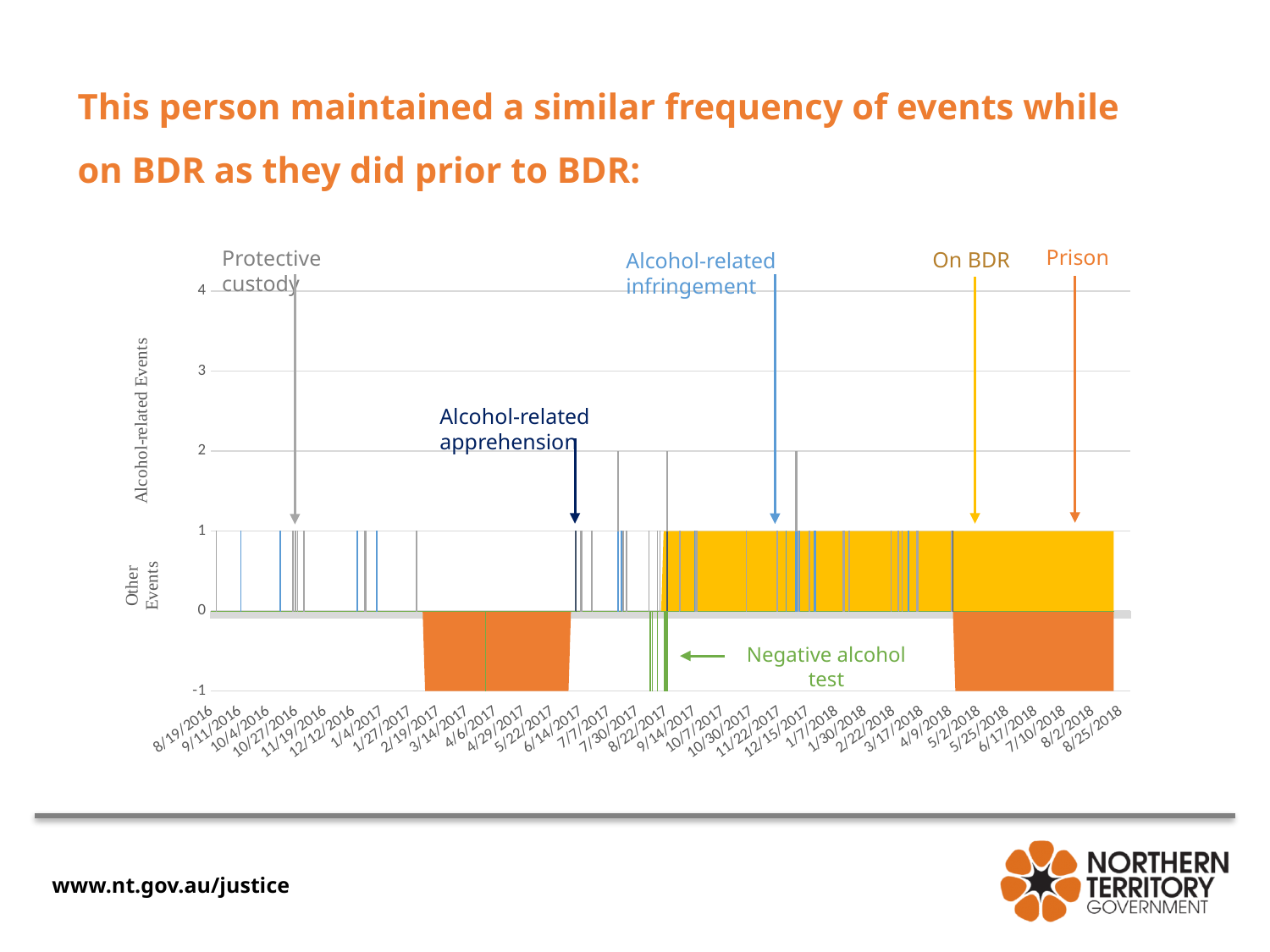
Is the value plotted for the On BDR period greater or less than 0? greater What kind of chart is shown on the slide? bar chart How many different event types are labelled with arrows on the chart? 6 Is the value plotted for the Negative alcohol test events greater or less than 0? less What is the label on the upper part of the vertical axis? Alcohol-related Events Is the value plotted for the Prison periods greater or less than 0? less Which event type is shown as the yellow shaded region on the chart? On BDR How many separate Prison periods (orange blocks) are plotted on the chart? 2